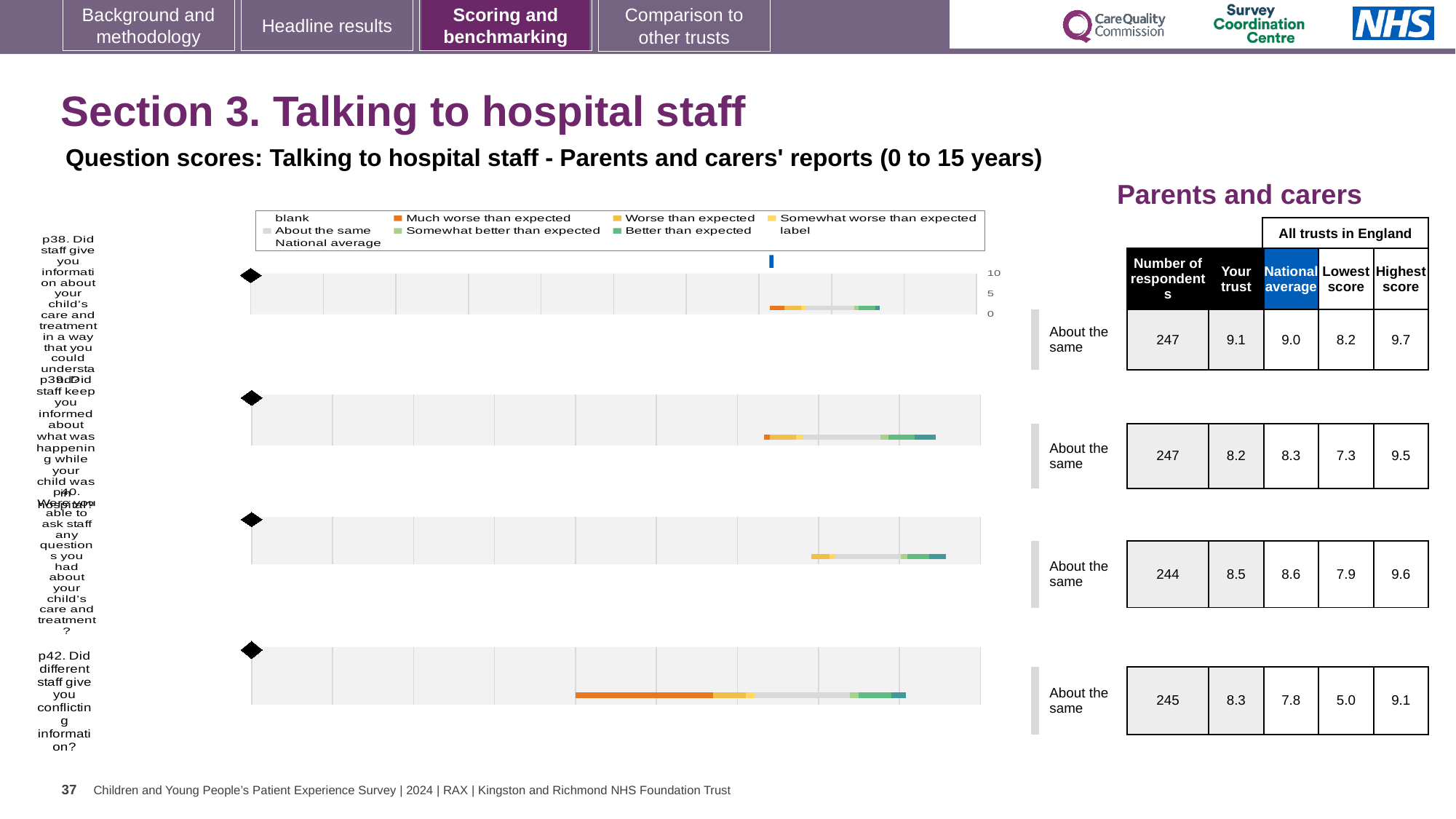
What colour does the legend use for 'Much worse than expected'? orange In the table on the right, which question has the highest 'Your trust' score? p38 What kind of chart is shown on the slide? bar chart In the table on the right, is the 'Your trust' score for p38 higher or lower than the national average for p38? higher In the table on the right, what is the lowest score across all trusts in England for p42? 5.0 In the table on the right, what is the difference between the 'Your trust' score and the national average for p42? 0.5 What benchmark category is shown next to each of the four bars? About the same In the table on the right, what is the national average for p42 (Did different staff give you conflicting information)? 7.8 How many question bars are plotted in the chart? 4 In the table on the right, which question has the lowest 'Lowest score' value? p42 In the table on the right, what is the 'Your trust' score for p38 (Did staff give you information about your child's care and treatment in a way that you could understand)? 9.1 In the table on the right, what is the number of respondents for p42? 245